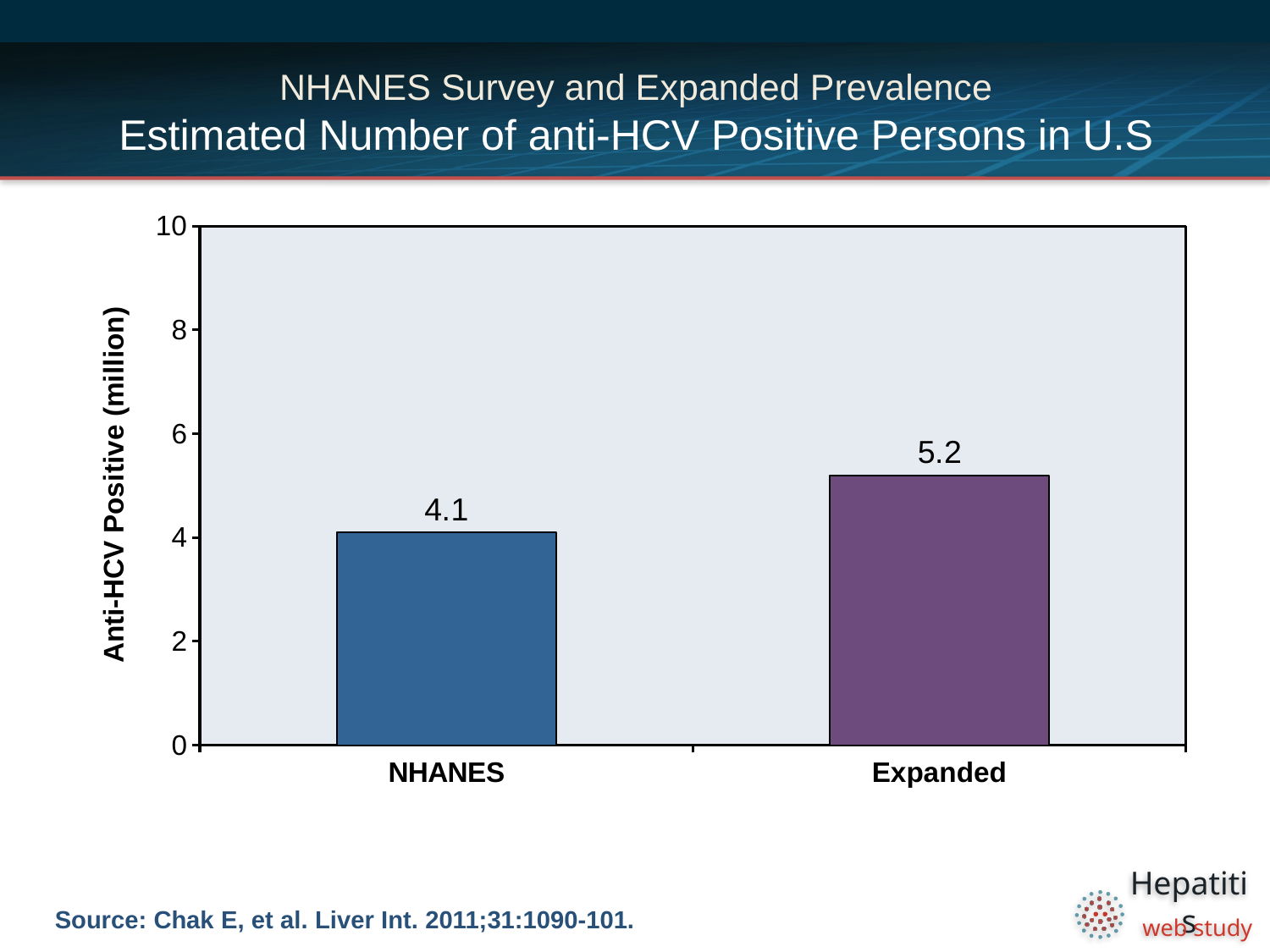
What kind of chart is shown on the slide? bar chart Is the value for Expanded greater or less than 6? less What is the difference between the Expanded and NHANES values? 1.1 Is the value for NHANES greater or less than the value for Expanded? less Which category has the lowest value? NHANES Is the value for NHANES greater or less than 4? greater What is the estimated number of anti-HCV positive persons (million) for NHANES? 4.1 What is the maximum value shown on the y axis? 10 What is the estimated number of anti-HCV positive persons (million) for Expanded? 5.2 What is the label of the y axis? Anti-HCV Positive (million) How many categories are shown on the x axis? 2 Which category has the higher value, NHANES or Expanded? Expanded